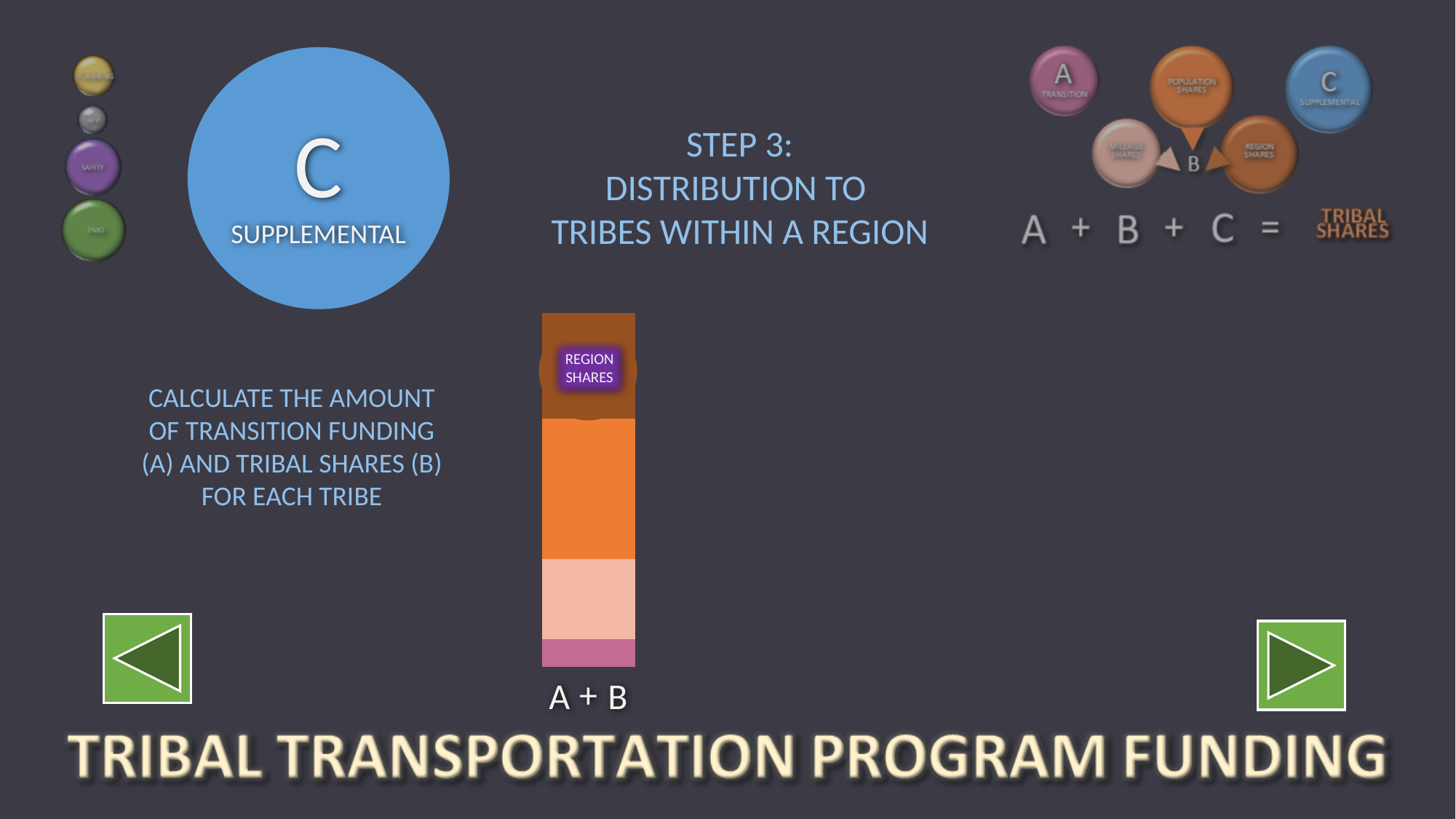
Which is taller in the stacked bar, the orange segment or the pink bottom segment? The orange segment Which segment of the stacked bar is the shortest? The pink segment at the bottom What label appears directly below the stacked bar? A + B Which segment of the stacked bar is the tallest? The orange segment What kind of chart is shown in the middle of the slide? Stacked bar chart How many segments make up the stacked bar? 4 What label is printed on the top (brown) segment of the stacked bar? REGION SHARES Which is taller in the stacked bar, the light pink segment or the pink bottom segment? The light pink segment